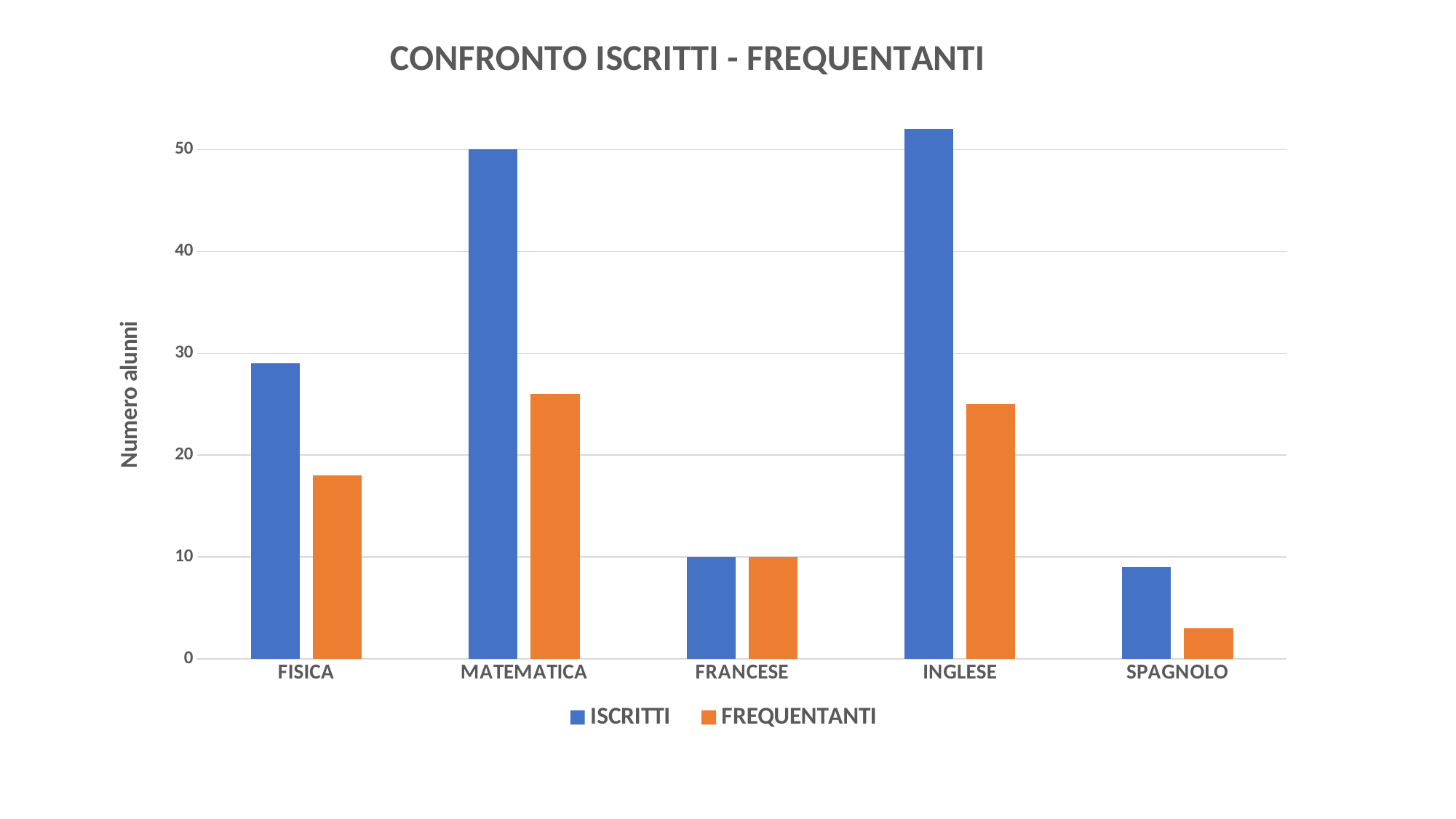
What is the ISCRITTI value for MATEMATICA? 50 Is the FREQUENTANTI value for INGLESE greater or less than 30? less What is the label of the vertical axis? Numero alunni What is the title of the chart? CONFRONTO ISCRITTI - FREQUENTANTI Which category has the highest ISCRITTI value? INGLESE Which category has the lowest FREQUENTANTI value? SPAGNOLO Is the ISCRITTI value for FISICA greater or less than 20? greater How many series does the legend list? 2 What is the FREQUENTANTI value for FRANCESE? 10 How many categories are shown on the x axis? 5 Which is larger: the ISCRITTI value for FISICA or the ISCRITTI value for SPAGNOLO? FISICA What type of chart is shown on the slide? bar chart